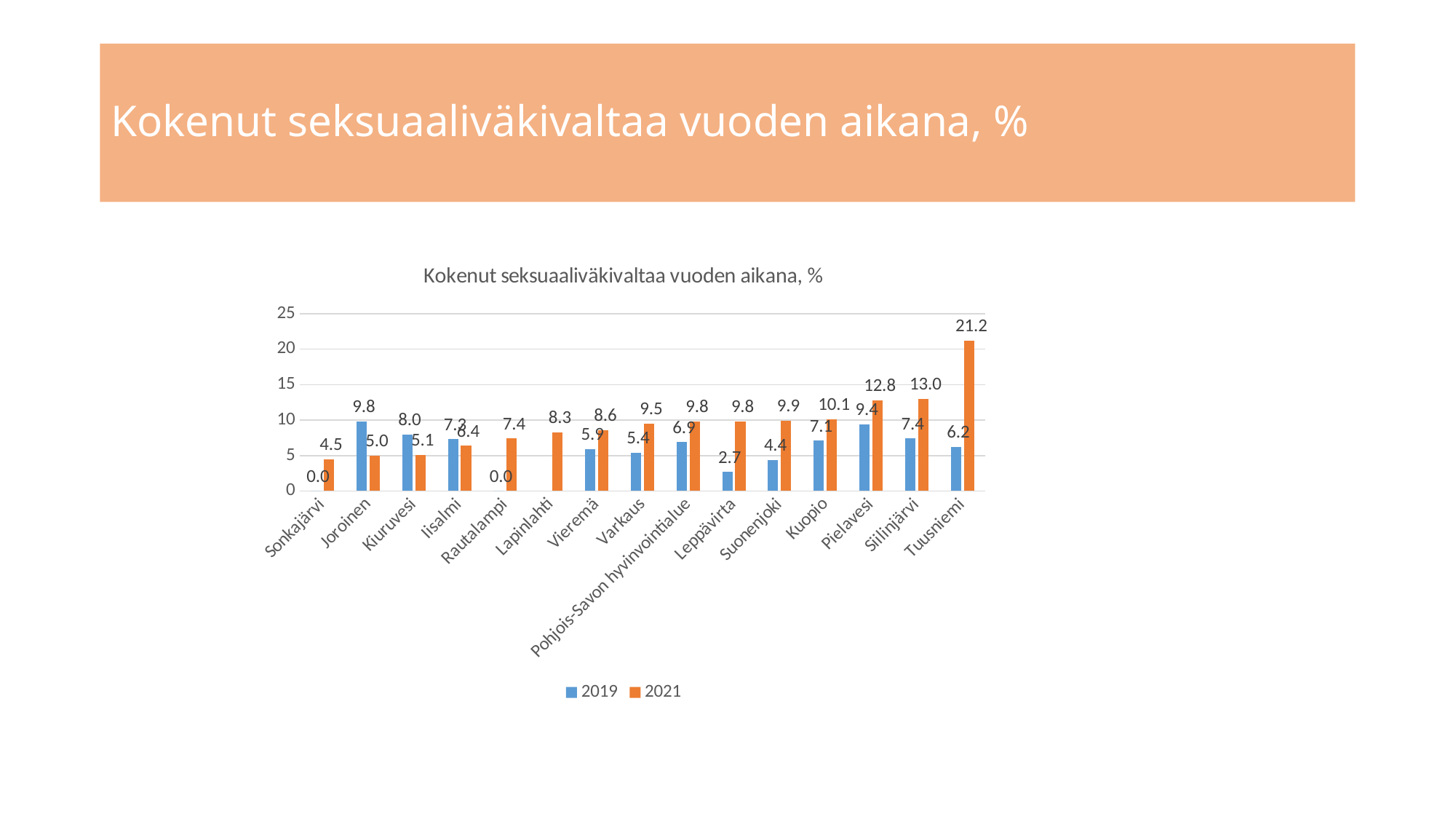
What kind of chart is shown on the slide? bar chart What is the 2019 value for Leppävirta? 2.7 Which category has the lowest 2021 value? Sonkajärvi Is the 2021 value for Pielavesi greater or less than 10? greater What is the 2021 value for Siilinjärvi? 13.0 What is the 2019 value for Joroinen? 9.8 How many series does the legend list? 2 Which category has the highest 2021 value? Tuusniemi Which is larger for Joroinen, the 2019 value or the 2021 value? 2019 How many categories are shown on the x axis? 15 What is the 2021 value for Tuusniemi? 21.2 What is the difference between the 2021 and 2019 values for Tuusniemi? 15.0